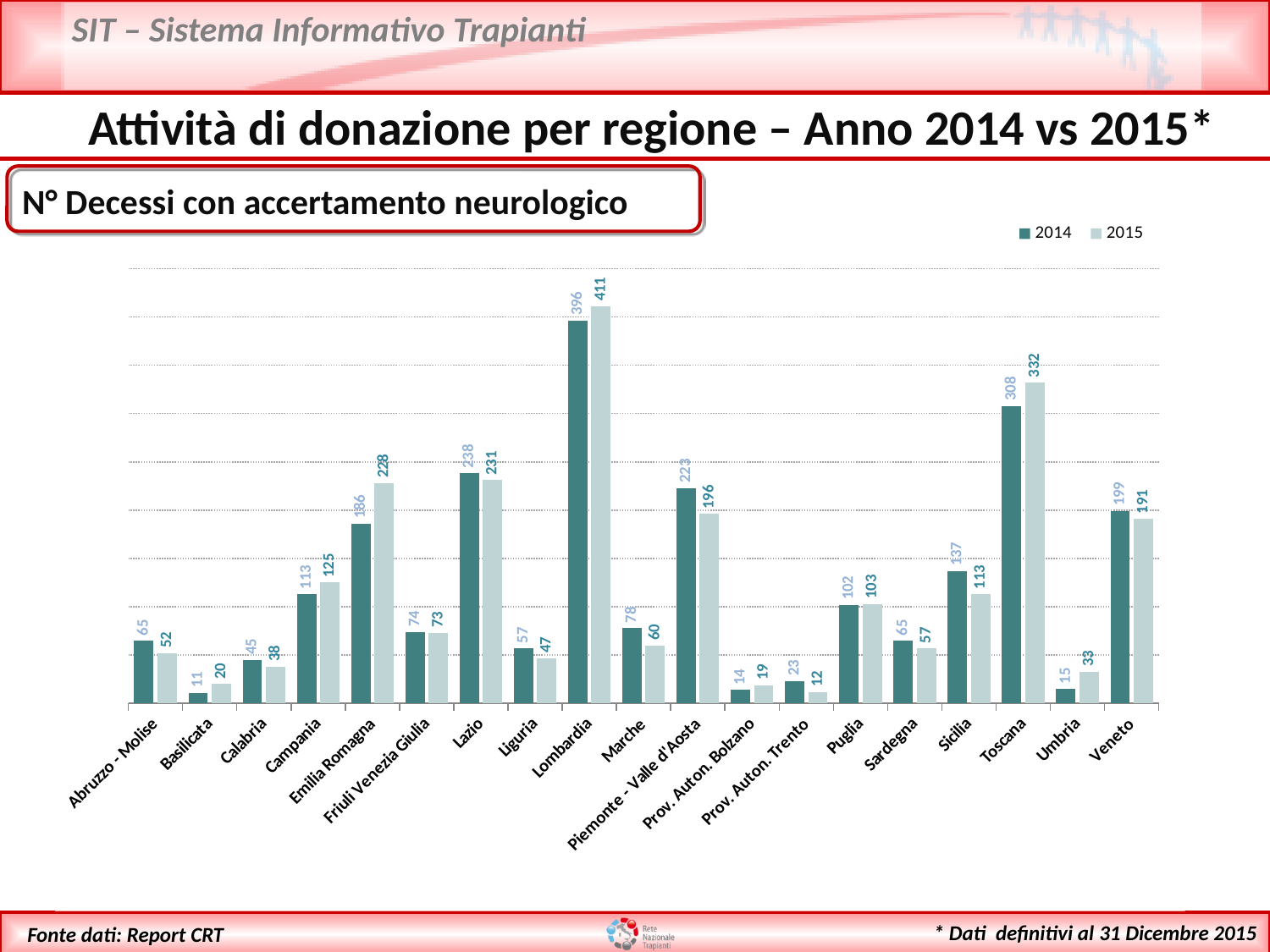
What is the difference between the 2015 and 2014 values for Lombardia? 15 Which region has the highest value in the 2015 series? Lombardia What is the difference between the 2015 and 2014 values for Emilia Romagna? 42 What kind of chart is shown on the slide? Bar chart Which region has the lowest value in the 2014 series? Basilicata In the 2015 series, which is larger: Toscana or Lazio? Toscana What is the value for Toscana in the 2014 series? 308 How many series does the legend list? 2 How many regions are shown on the x axis? 19 What is the value for Campania in the 2015 series? 125 What is the value for Lombardia in the 2015 series? 411 For Lazio, which series has the larger value, 2014 or 2015? 2014